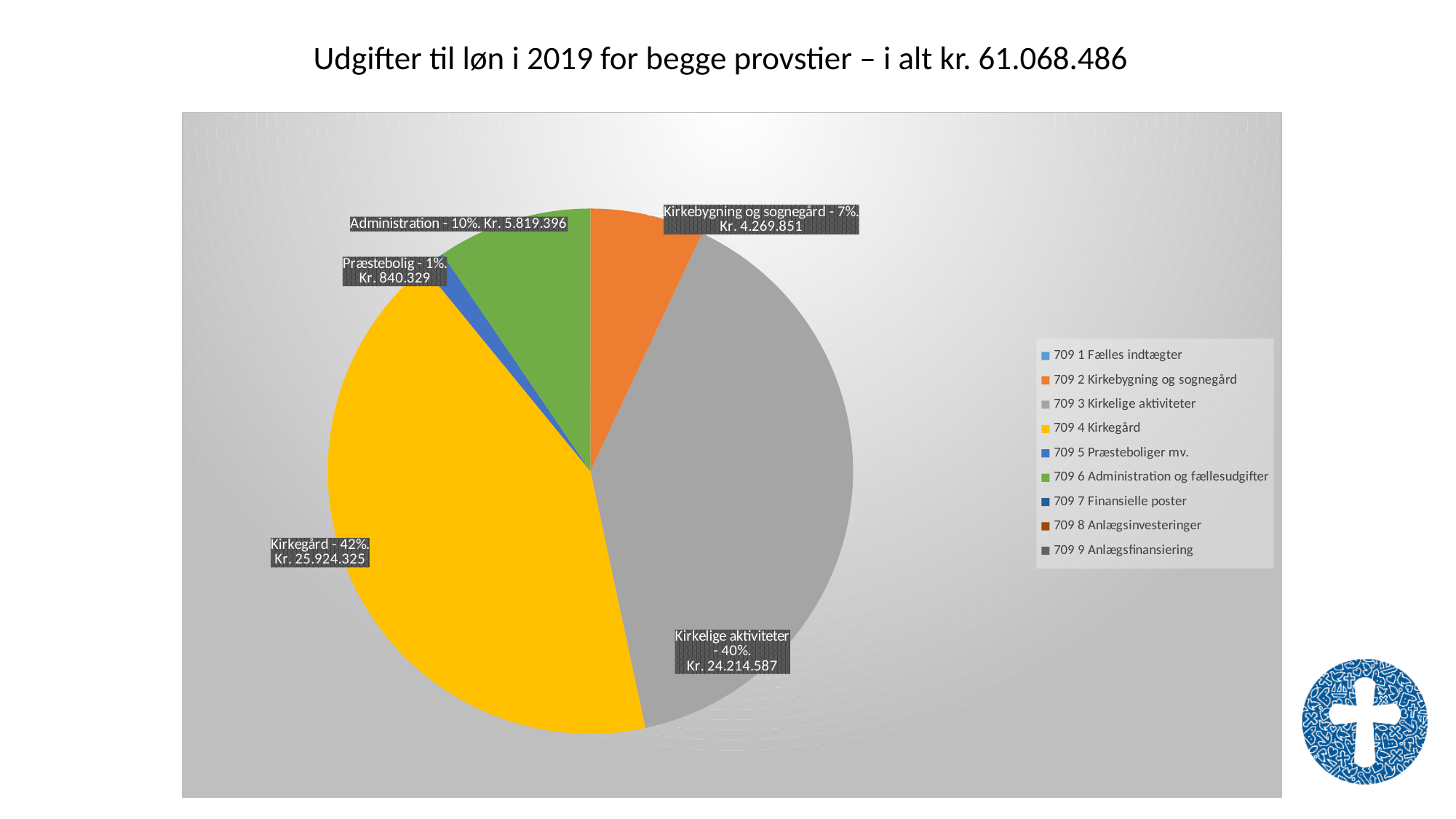
What is the value for Præstebolig? Kr. 840.329 What kind of chart is shown on the slide? pie chart What share of the pie does Kirkebygning og sognegård represent? 7% What share of the pie does Kirkegård represent? 42% Which category has the largest slice? Kirkegård How many entries does the legend list? 9 What is the value for Kirkegård? Kr. 25.924.325 What is the value for Administration? Kr. 5.819.396 What is the value for Kirkelige aktiviteter? Kr. 24.214.587 Which category has the smallest slice? Præstebolig Which is larger, the value for Administration or the value for Kirkebygning og sognegård? Administration What is the difference between the values for Kirkegård and Kirkelige aktiviteter? Kr. 1.709.738